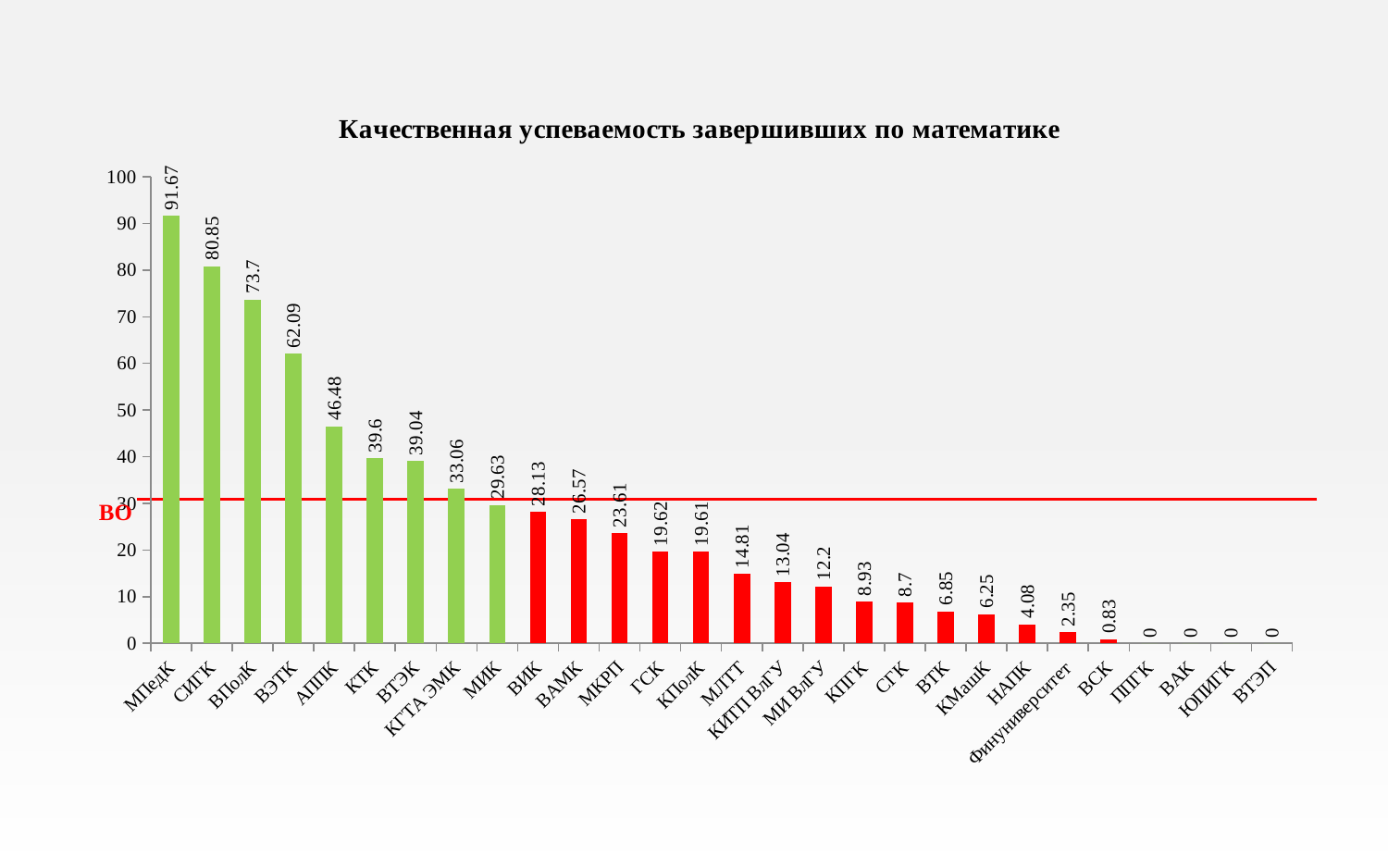
Do the values rise or fall from left to right along the x axis? fall What is the value for КИТП ВлГУ? 13.04 What is the value for Финуниверситет? 2.35 What is the lowest value shown on the chart? 0 What is the value for МПедК? 91.67 What is the value for ВЭТК? 62.09 How many categories are shown on the x axis? 28 Which category has the highest value? МПедК Is the value for ВИК greater or less than 30? less What is the difference between the values for СИГК and ВПолК? 7.15 What kind of chart is this? bar chart Which is larger, the value for АППК or the value for КТК? АППК